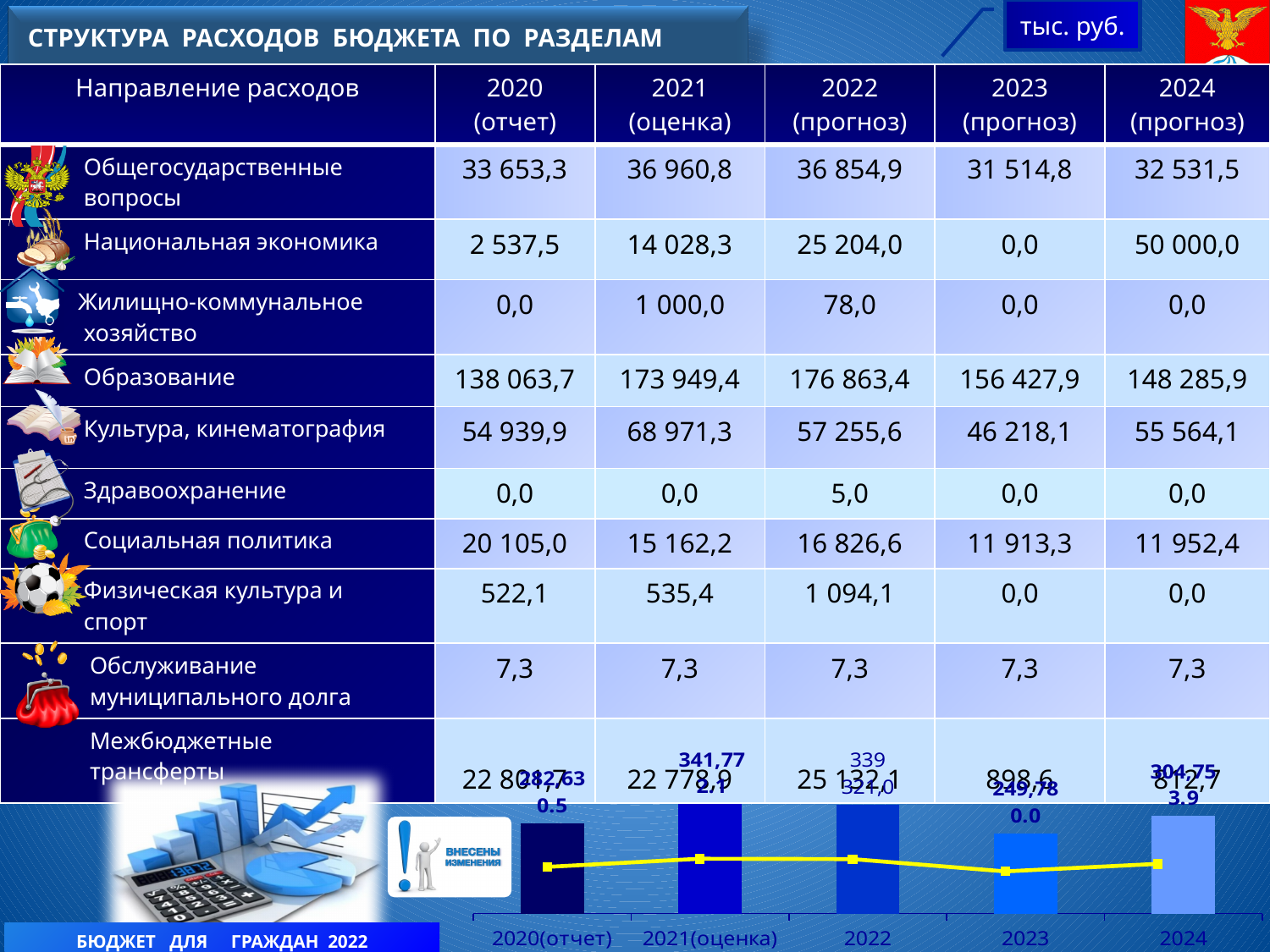
In the bar chart at the bottom of the slide, what colour is the line plotted over the bars? yellow In the bar chart at the bottom of the slide, what is the value of the bar for 2023? 249,780.0 In the bar chart at the bottom of the slide, which year has the tallest bar? 2021(оценка) In the bar chart at the bottom of the slide, how many categories are shown on the x axis? 5 In the bar chart at the bottom of the slide, what is the value of the bar for 2020(отчет)? 282,630.5 In the bar chart at the bottom of the slide, what is the difference between the bar values for 2021(оценка) and 2020(отчет)? 59,141.6 In the bar chart at the bottom of the slide, what is the value of the bar for 2021(оценка)? 341,772.1 In the bar chart at the bottom of the slide, what is the value of the bar for 2024? 304,753.9 In the bar chart at the bottom of the slide, which year has the shortest bar? 2023 In the bar chart at the bottom of the slide, what is the label of the first category on the x axis? 2020(отчет) In the bar chart at the bottom of the slide, is the bar for 2022 taller or shorter than the bar for 2024? taller In the bar chart at the bottom of the slide, what is the difference between the bar values for 2021(оценка) and 2023? 91,992.1